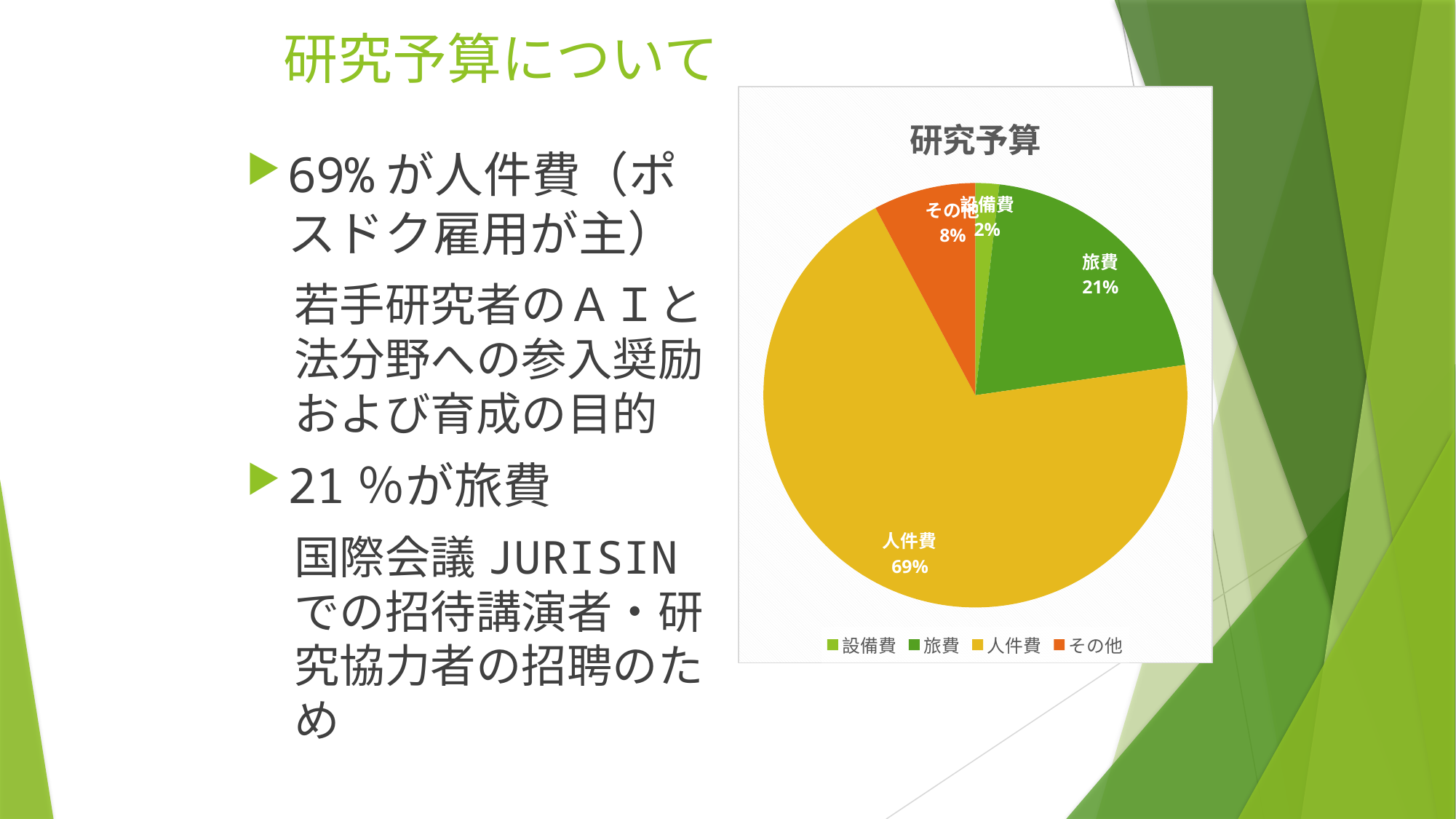
What share of the pie does 旅費 represent? 21% Which is larger, the share for 旅費 or the share for その他? 旅費 What share of the pie does その他 represent? 8% What is the title of the chart? 研究予算 What share of the pie does 人件費 represent? 69% Which category has the largest share of the pie? 人件費 What is the difference in percentage points between 人件費 and 旅費? 48 How many categories does the legend list? 4 Which category has the smallest share of the pie? 設備費 What colour is the 人件費 slice? yellow What type of chart is shown on the slide? pie chart